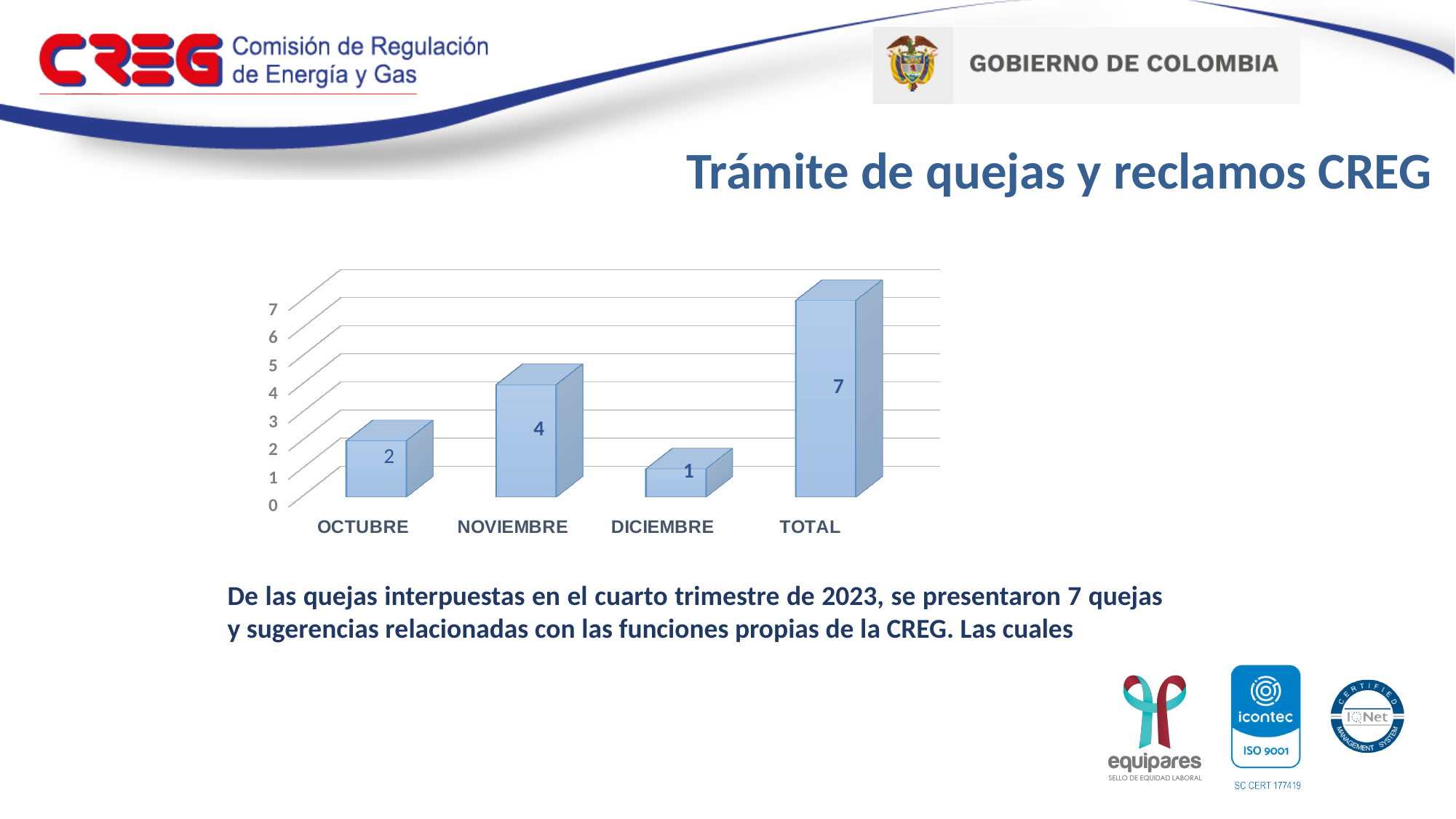
Which category has the highest value? TOTAL Which is larger, the value for OCTUBRE or the value for DICIEMBRE? OCTUBRE What is the value for NOVIEMBRE? 4 What kind of chart is shown on the slide? bar chart What is the value for OCTUBRE? 2 What is the value for DICIEMBRE? 1 Is the value for NOVIEMBRE greater or less than 3? greater What is the highest tick value shown on the vertical axis? 7 How many categories are shown on the x axis? 4 What is the value for TOTAL? 7 Which category has the lowest value? DICIEMBRE What is the difference between the values for NOVIEMBRE and OCTUBRE? 2